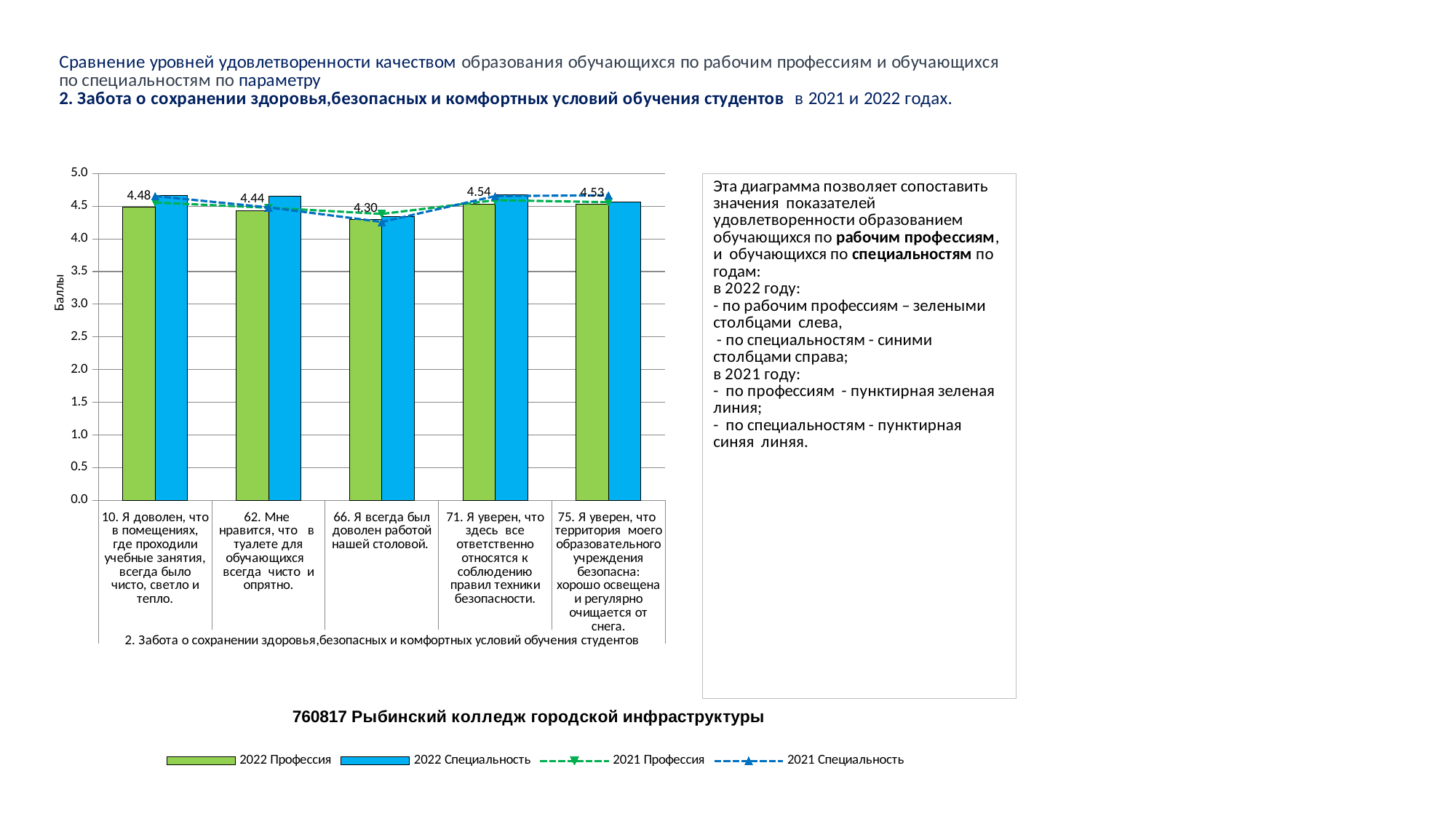
Is the 2022 Специальность value for category 62 greater or less than 4.5? greater In the 2022 Профессия series, which is larger: the value for category 10 or the value for category 62? Category 10 (4.48) Is the 2022 Специальность value for category 66 greater or less than 4.5? less What is the label of the vertical axis? Баллы What is the value of the 2022 Профессия series for category 71 (Я уверен, что здесь все ответственно относятся к соблюдению правил техники безопасности)? 4.54 What is the value of the 2022 Профессия series for category 66 (Я всегда был доволен работой нашей столовой)? 4.30 What is the difference between the 2022 Профессия values for category 71 and category 66? 0.24 How many series does the legend list? 4 Which category has the highest value in the 2022 Профессия series? 71. Я уверен, что здесь все ответственно относятся к соблюдению правил техники безопасности. Which category has the lowest value in the 2022 Профессия series? 66. Я всегда был доволен работой нашей столовой. What is the value of the 2022 Профессия series for category 10 (Я доволен, что в помещениях, где проходили учебные занятия, всегда было чисто, светло и тепло)? 4.48 How many categories are shown on the x axis of the chart? 5